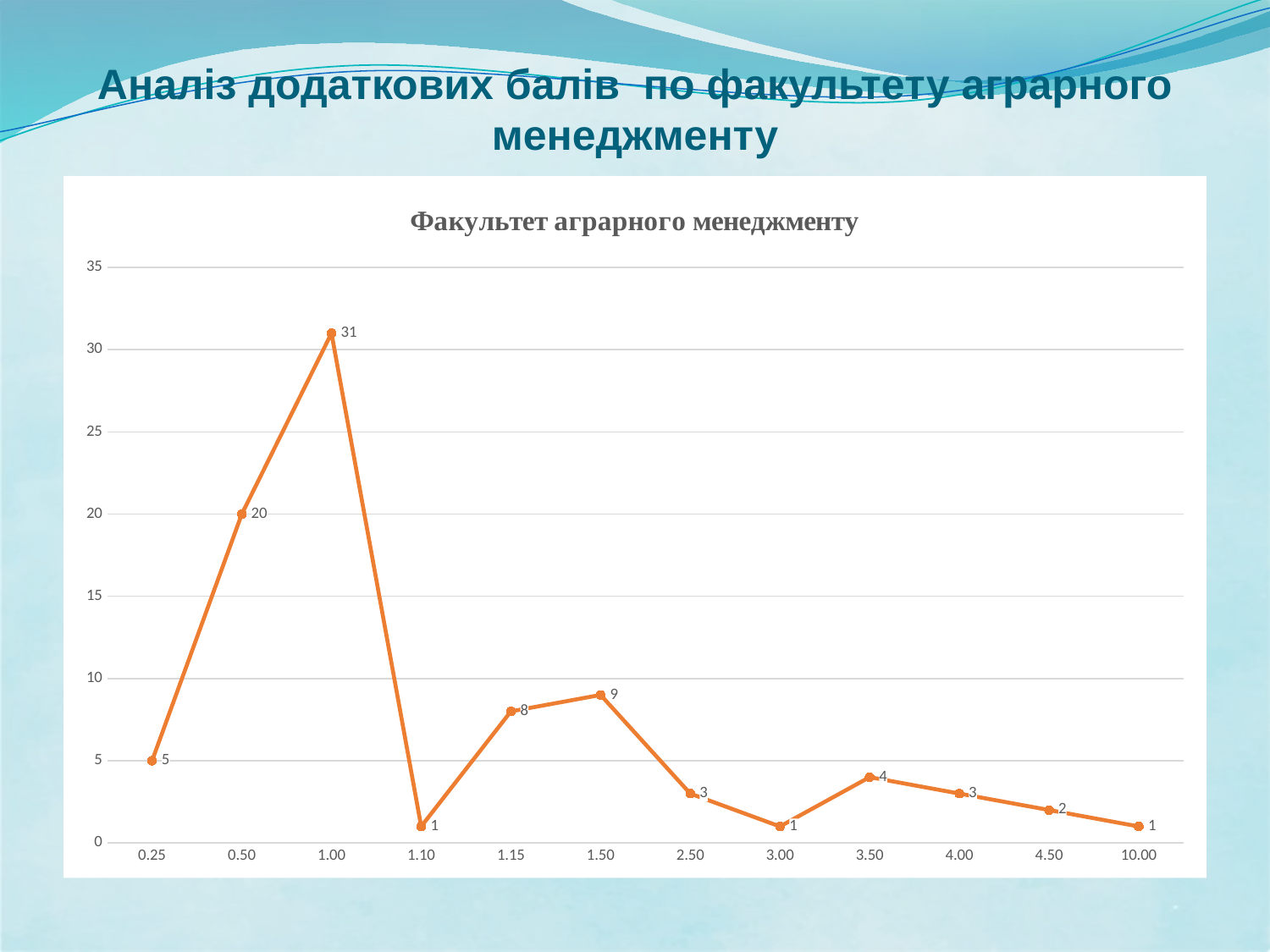
At which x-axis category is the value highest? 1.00 What kind of chart is shown on the slide? line chart What is the difference between the values at 1.15 and 2.50? 5 What is the value at x = 3.50? 4 Which is larger, the value at 0.25 or the value at 1.15? 1.15 Is the value at 1.00 greater or less than 30? greater How many data points are plotted on the chart? 12 What is the difference between the values at 1.00 and 0.50? 11 What is the title of the chart? Факультет аграрного менеджменту What is the value at x = 1.50? 9 What is the value at x = 1.00? 31 What is the value at x = 0.50? 20